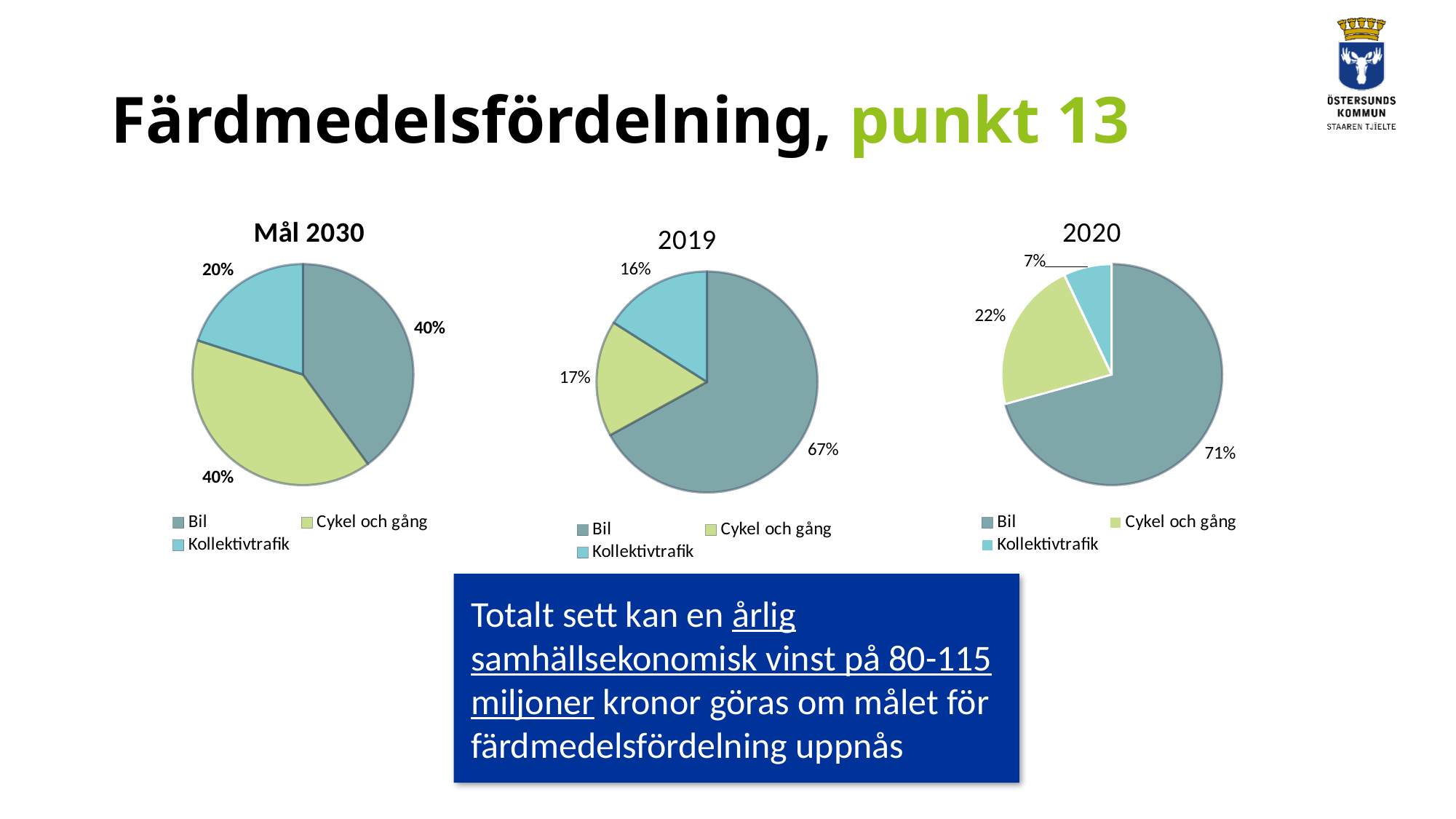
In the 'Mål 2030' chart, what share is Kollektivtrafik? 20% In the '2019' chart, which is larger, Cykel och gång or Kollektivtrafik? Cykel och gång In the '2020' chart, what share is Kollektivtrafik? 7% In the 'Mål 2030' chart, what share is Bil? 40% How many categories does the legend of the '2019' chart list? 3 In the '2020' chart, what is the difference between the Bil share and the Cykel och gång share? 49% How many pie charts are shown on the slide? 3 In the '2019' chart, what share is Bil? 67% In the 'Mål 2030' chart, which category has the smallest slice? Kollektivtrafik In the '2020' chart, which category has the largest slice? Bil In the '2019' chart, what share is Cykel och gång? 17% What kind of chart is the '2020' chart? Pie chart